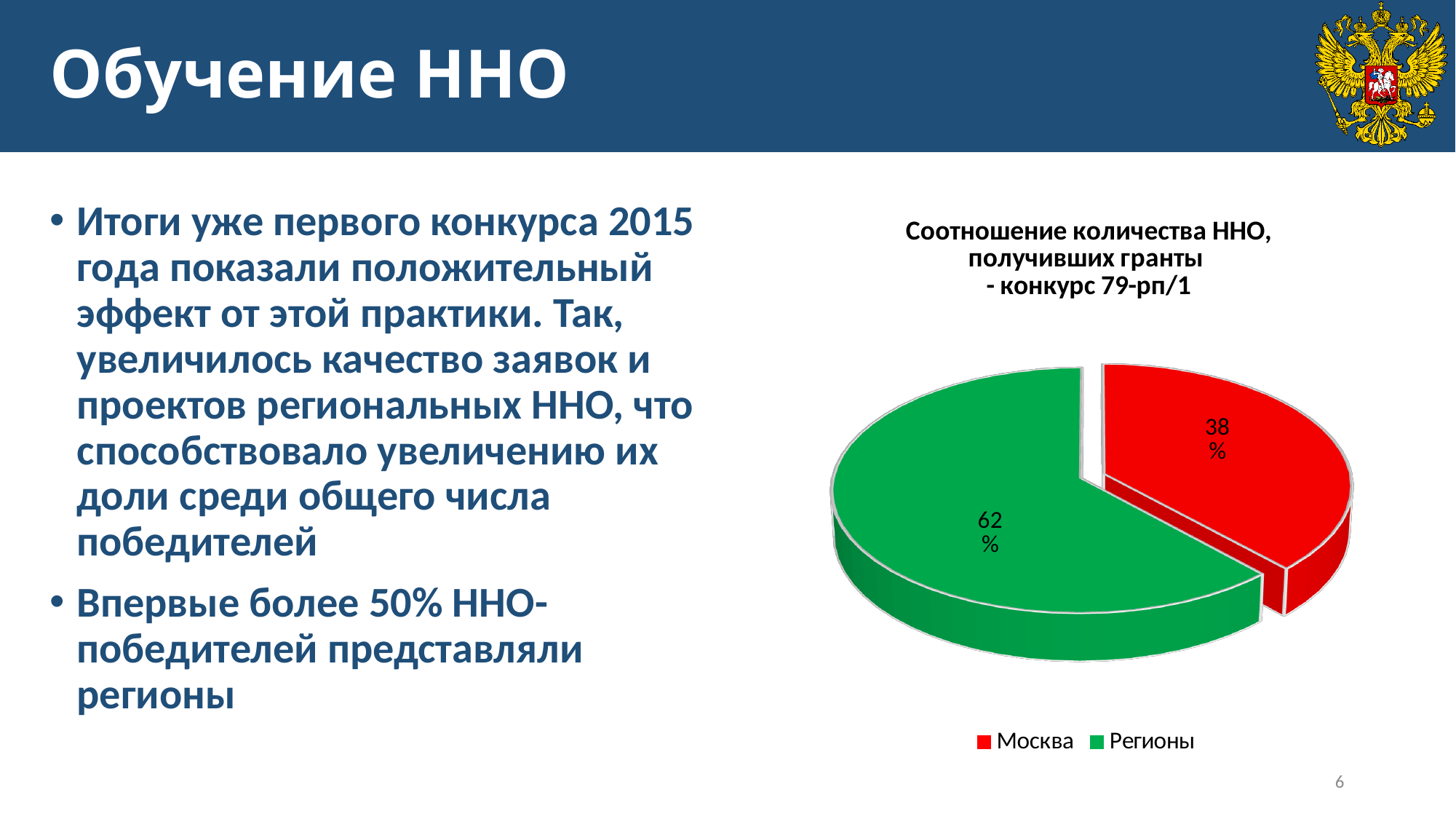
How many categories does the pie chart show? 2 What is the title of the chart? Соотношение количества ННО, получивших гранты - конкурс 79-рп/1 What colour is the slice for Москва? red What is the difference between the share for Регионы and the share for Москва? 24% Which category has the smallest share of the pie? Москва What share of the pie does Регионы have? 62% Which category has the largest share of the pie? Регионы Which is larger, the share for Москва or the share for Регионы? Регионы What kind of chart is shown on the slide? pie chart What share of the pie does Москва have? 38% How many entries does the legend list? 2